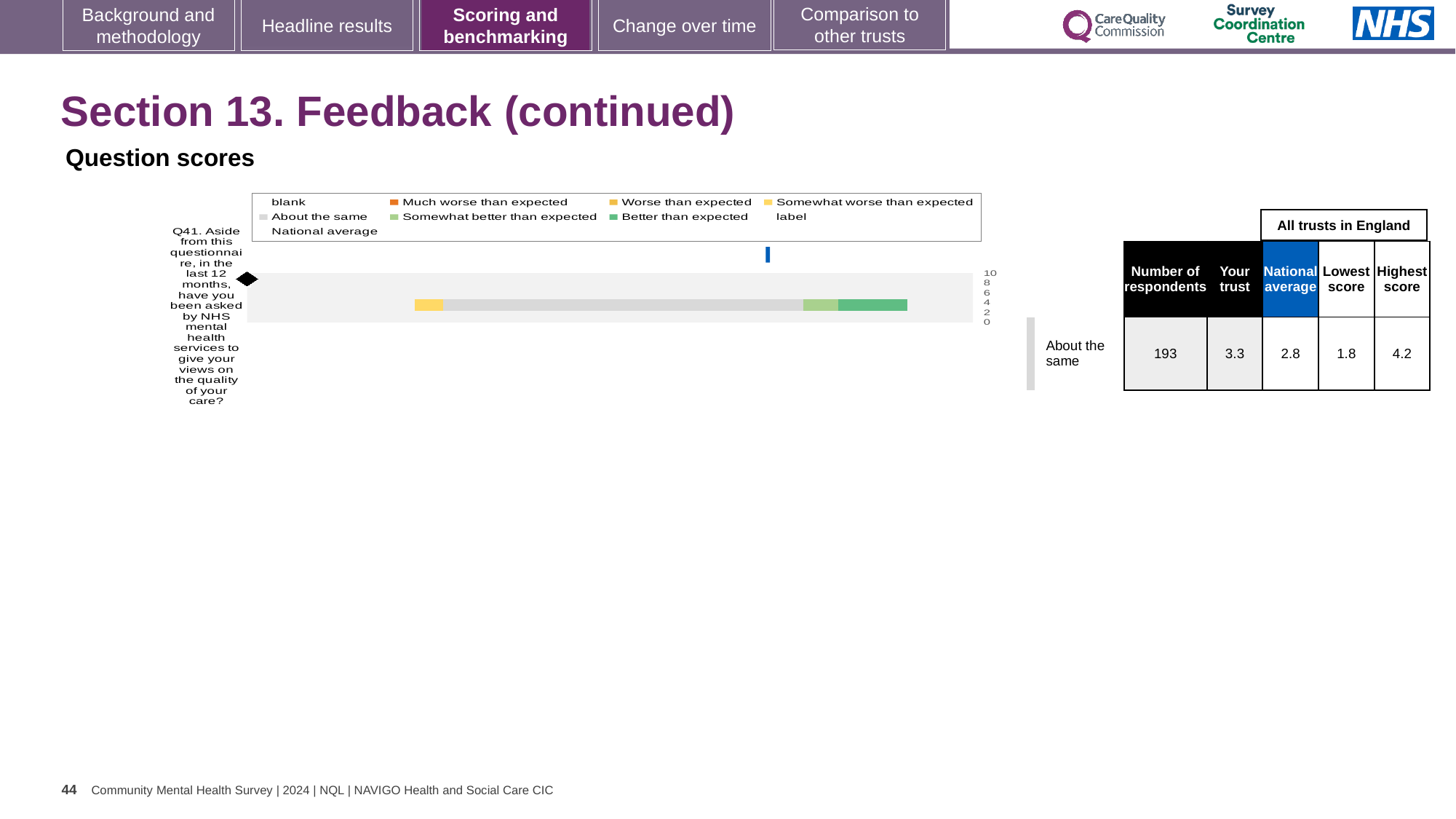
What is the difference between the 'Your trust' score and the National average for Q41? 0.5 According to the table beside the chart, how many respondents answered Q41? 193 According to the table beside the chart, what is the lowest score among all trusts in England for Q41? 1.8 Which question is plotted on the chart? Q41. Aside from this questionnaire, in the last 12 months, have you been asked by NHS mental health services to give your views on the quality of your care? What is the highest tick value shown on the chart's numeric axis? 10 According to the table beside the chart, what is the National average score for Q41? 2.8 How many entries does the chart's legend list? 9 What kind of chart is shown on the slide? Stacked bar chart According to the table beside the chart, what is the highest score among all trusts in England for Q41? 4.2 Is the 'Your trust' score for Q41 higher or lower than the National average? Higher How many questions (categories) are plotted on the chart's vertical axis? 1 According to the table beside the chart, what is the 'Your trust' score for Q41? 3.3